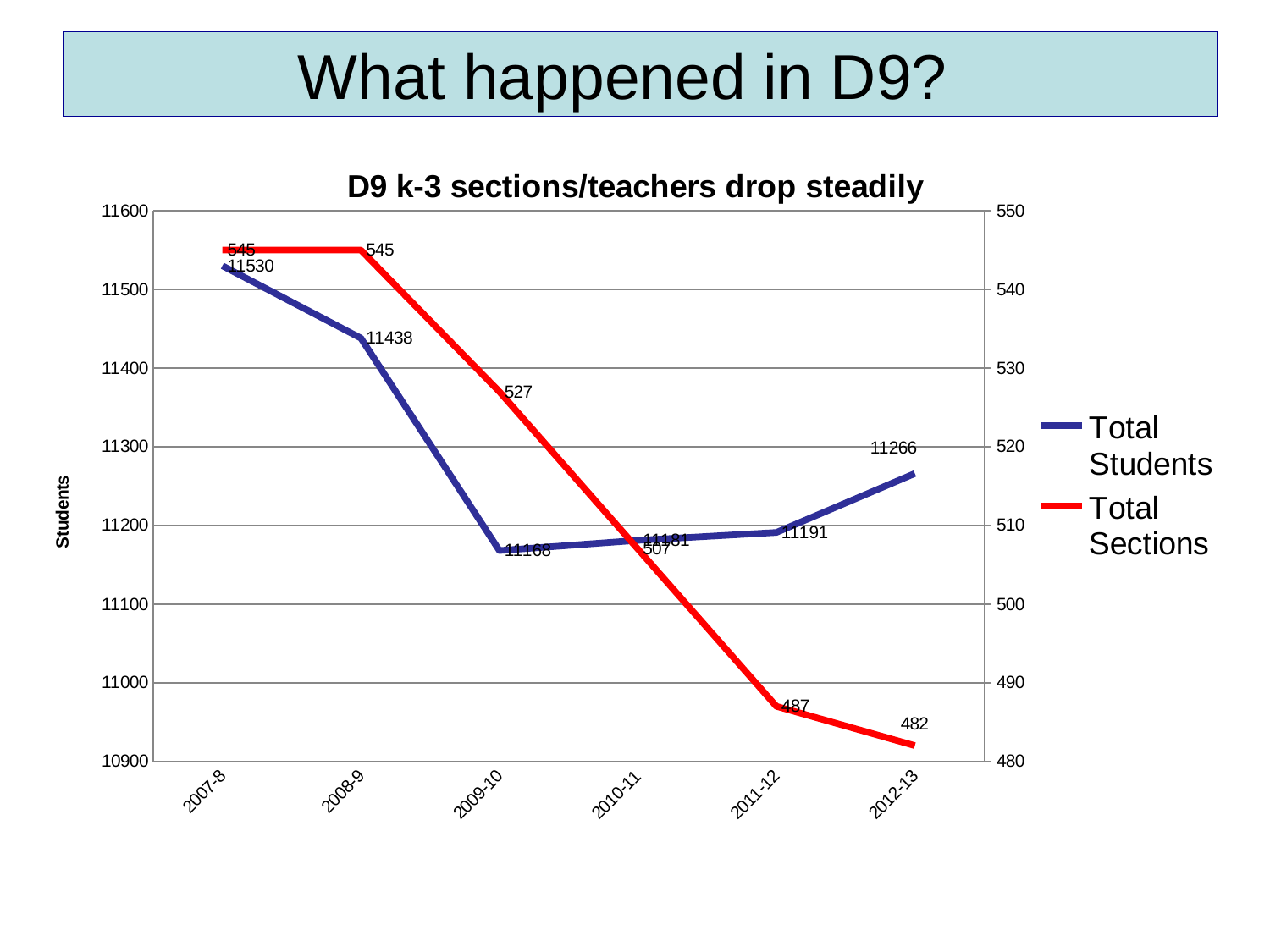
What is the value of Total Sections in 2009-10? 527 Does Total Sections rise or fall across the years shown? fall What kind of chart is shown on the slide? line chart What is the value of Total Sections in 2012-13? 482 How many school years are plotted along the x axis? 6 Which is larger, Total Students in 2008-9 or in 2012-13? 2008-9 By how much did Total Sections fall from 2007-8 to 2012-13? 63 What is the value of Total Students in 2007-8? 11530 How many series does the legend list? 2 What is the value of Total Students in 2011-12? 11191 In which year is Total Sections lowest? 2012-13 In which year is Total Students highest? 2007-8